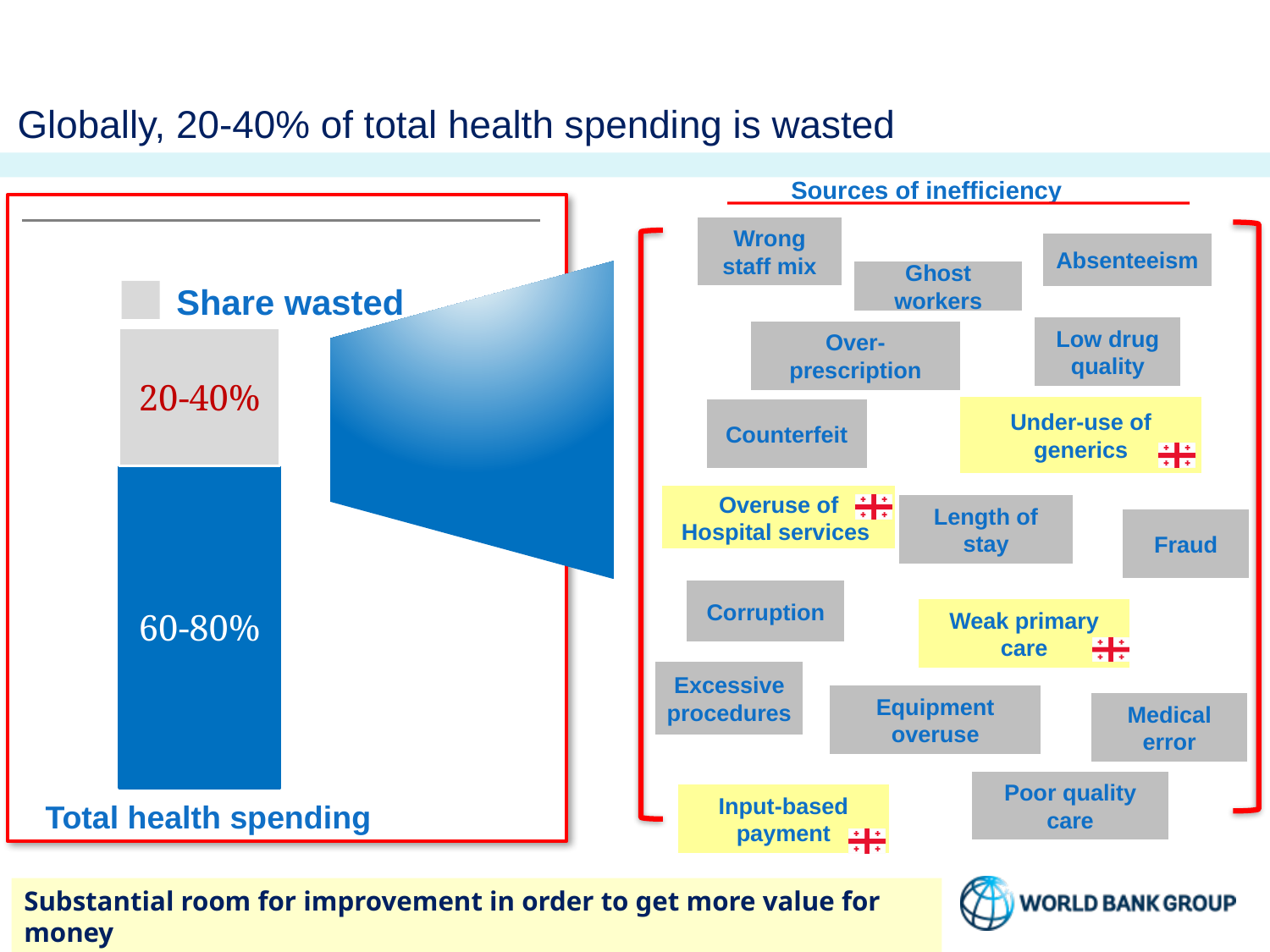
In the Total health spending bar chart, which segment is larger: the grey 'Share wasted' segment or the blue segment? the blue segment (60-80%) In the Total health spending bar chart, which segment takes up the smallest part of the bar? the grey 20-40% 'Share wasted' segment In the Total health spending bar chart, what share of spending is labelled as wasted? 20-40% In the Total health spending bar chart, what value is printed on the blue segment of the bar? 60-80% How many series does the legend of the Total health spending bar chart list? 1 What is the only legend entry shown for the Total health spending bar chart? Share wasted What kind of chart is used to show Total health spending on the left of the slide? bar chart What colour is the 'Share wasted' segment in the Total health spending bar chart? grey How many segments make up the Total health spending bar? 2 In the Total health spending bar chart, which segment takes up the largest part of the bar? the blue 60-80% segment